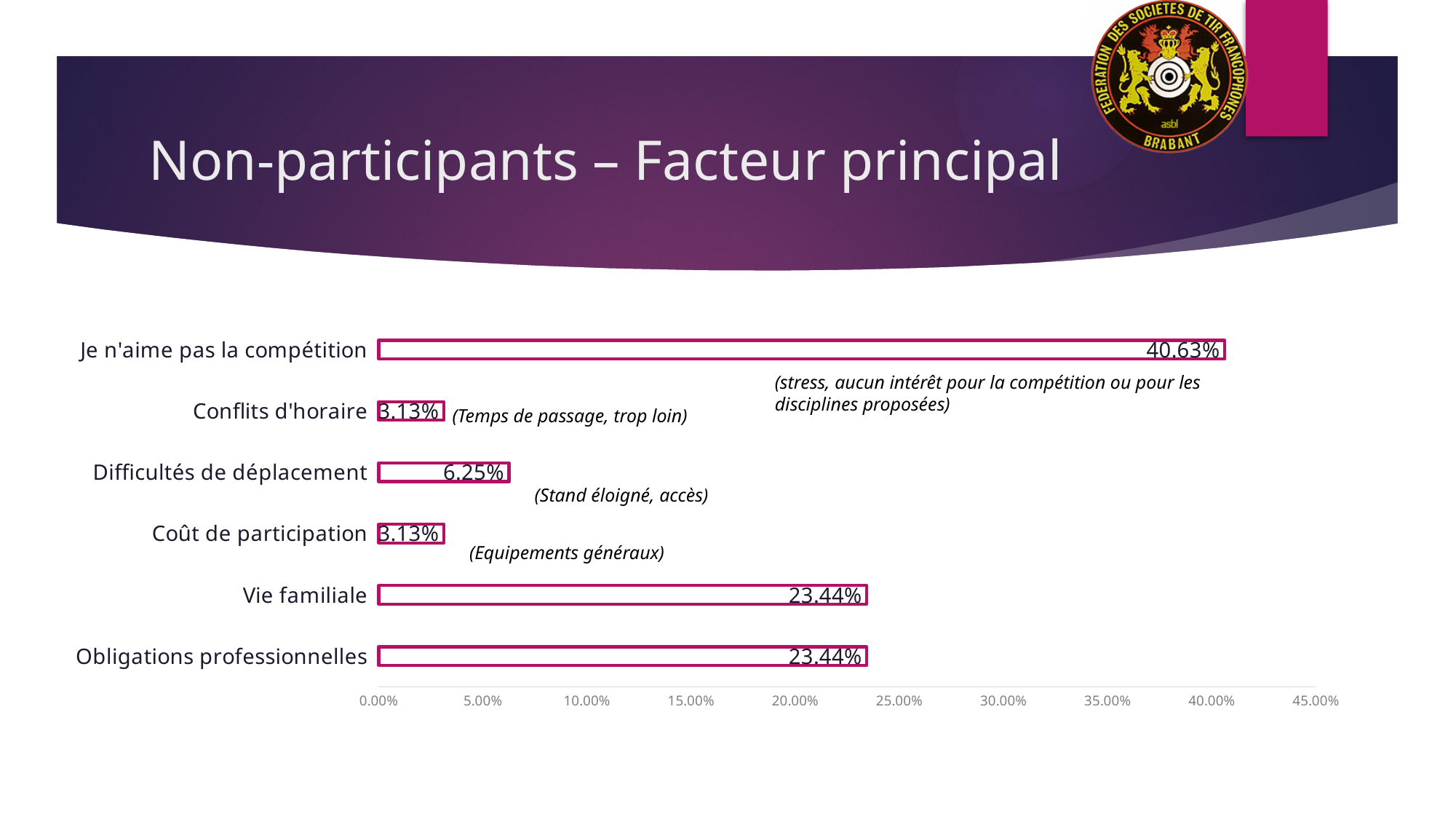
What kind of chart is shown on the slide? bar chart What is the value for "Je n'aime pas la compétition"? 40.63% How many categories are shown in the chart? 6 Is the value for "Obligations professionnelles" greater or less than 20.00%? greater What is the value for "Difficultés de déplacement"? 6.25% What is the value for "Vie familiale"? 23.44% Which category has the highest value? Je n'aime pas la compétition What is the difference between "Difficultés de déplacement" and "Coût de participation"? 3.12% What is the value for "Conflits d'horaire"? 3.13% Which is larger, "Difficultés de déplacement" or "Coût de participation"? Difficultés de déplacement What is the title of the slide containing the chart? Non-participants – Facteur principal What is the difference between "Je n'aime pas la compétition" and "Vie familiale"? 17.19%